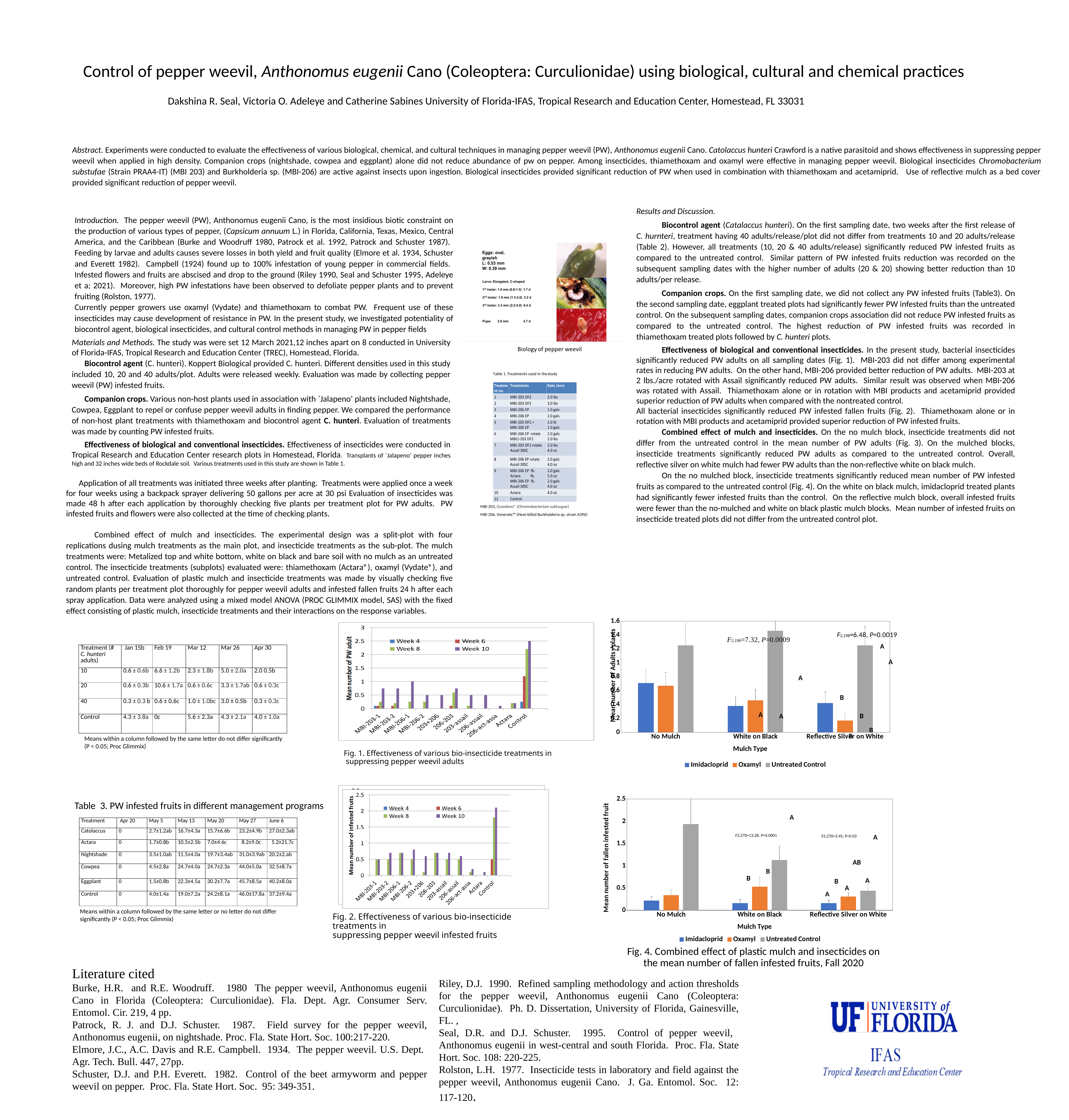
In Fig. 1 (suppressing pepper weevil adults), which treatment has the tallest bar? Control In Fig. 4 (mean number of fallen infested fruits), for No Mulch, which is larger: Imidacloprid or Untreated Control? Untreated Control In the top-right chart (Mean number of Adults/plants by Mulch Type), is the Untreated Control value for White on Black greater or less than 1? greater In Fig. 1 (suppressing pepper weevil adults), how many series does the legend list? 4 In Fig. 4 (mean number of fallen infested fruits), which mulch type has the lowest Untreated Control bar? Reflective Silver on White In Fig. 1 (suppressing pepper weevil adults), how many treatment categories are shown on the x axis? 11 In Fig. 4 (mean number of fallen infested fruits), is the Untreated Control value for No Mulch greater or less than 1.5? greater In Fig. 4 (mean number of fallen infested fruits), what is the title of the x axis? Mulch Type In Fig. 1 (Effectiveness of various bio-insecticide treatments in suppressing pepper weevil adults), what kind of chart is shown? Bar chart In Fig. 2 (suppressing pepper weevil infested fruits), is the Week 10 value for Control greater or less than 1.5? greater In Fig. 4 (Combined effect of plastic mulch and insecticides on the mean number of fallen infested fruits), how many series does the legend list? 3